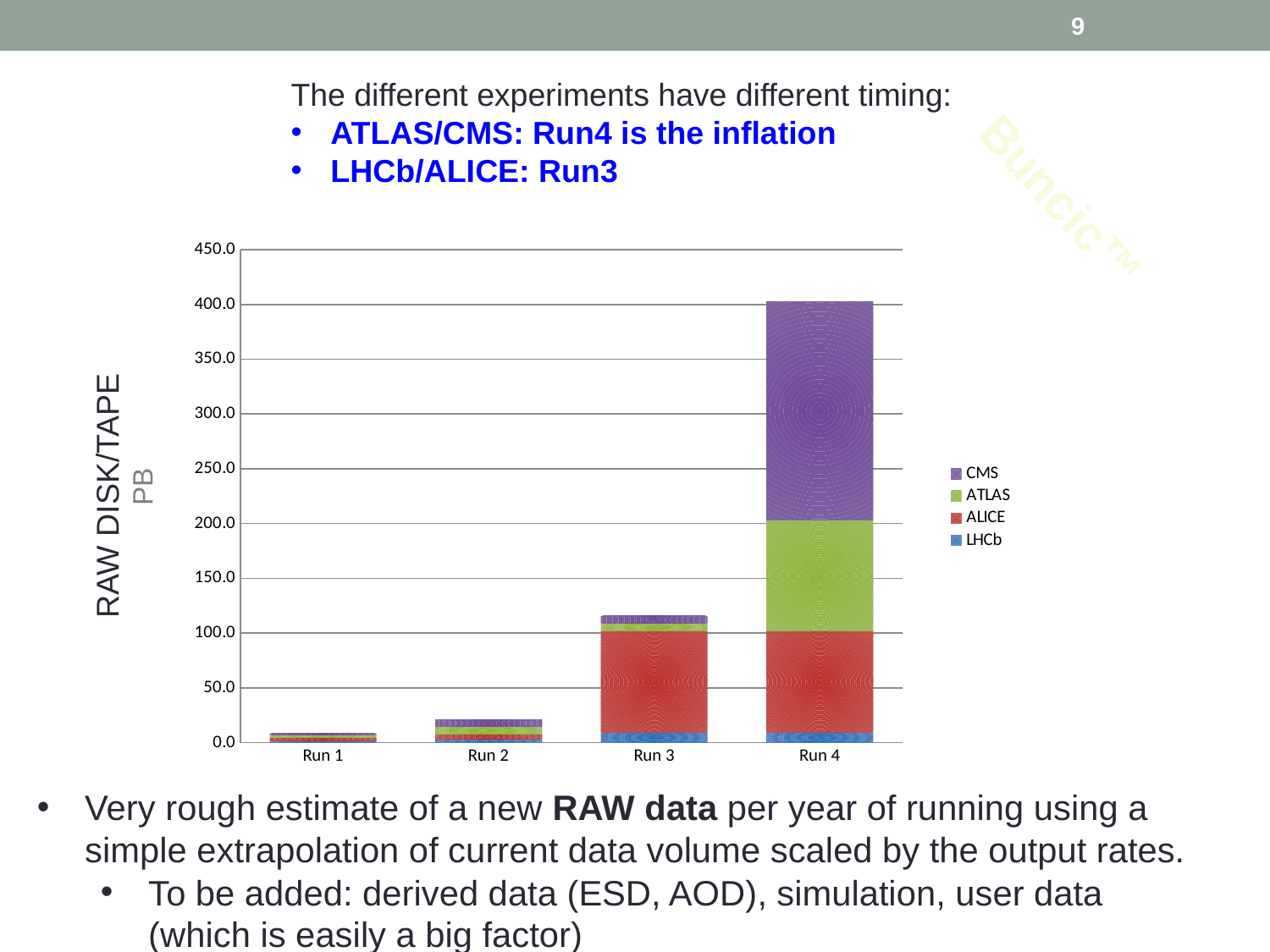
Do the total bar heights rise or fall from Run 1 to Run 4? rise Which series is shown at the bottom of each stacked bar in the chart? LHCb Which has the larger total bar, Run 2 or Run 3? Run 3 How many run categories are shown on the x axis of the chart? 4 Is the total value for Run 3 greater or less than 100.0? greater How many series does the chart's legend list? 4 Is the total value for Run 4 greater or less than 350.0? greater What is the label on the vertical axis of the chart? RAW DISK/TAPE PB Which run has the highest total stacked bar in the chart? Run 4 Is the total value for Run 2 greater or less than 50.0? less What type of chart is shown on the slide? stacked bar chart Which run has the lowest total stacked bar in the chart? Run 1